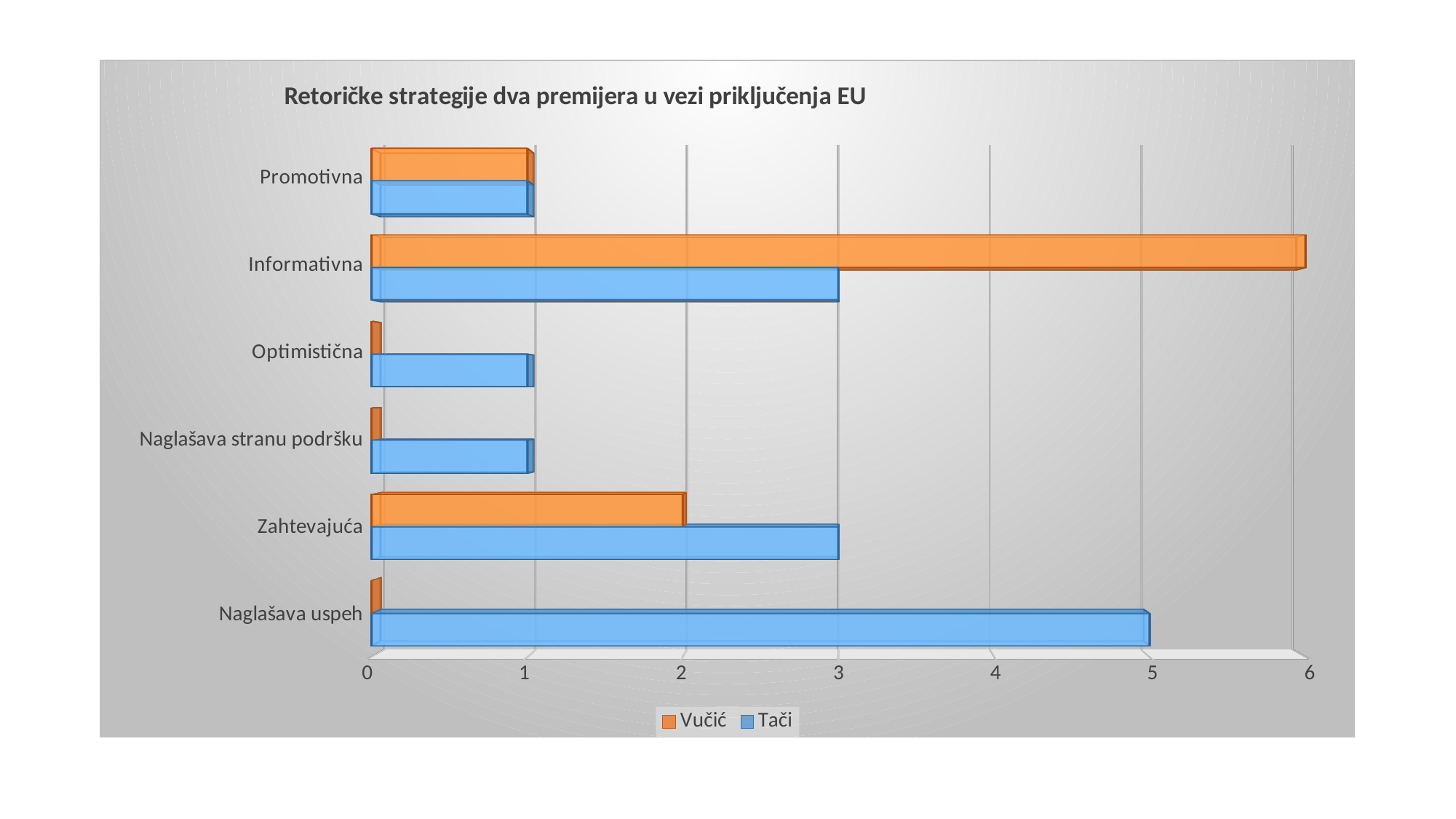
Which category has the highest value for Vučić? Informativna In the Zahtevajuća category, which is larger, the value for Vučić or the value for Tači? Tači How many categories are shown on the chart? 6 What is the value for Tači in the Zahtevajuća category? 3 What is the value for Vučić in the Zahtevajuća category? 2 What is the value for Vučić in the Informativna category? 6 What is the difference between the Vučić and Tači values in the Informativna category? 3 What is the title of the chart? Retoričke strategije dva premijera u vezi priključenja EU What kind of chart is shown on the slide? bar chart How many series does the legend list? 2 What is the value for Tači in the Naglašava uspeh category? 5 Which category has the highest value for Tači? Naglašava uspeh